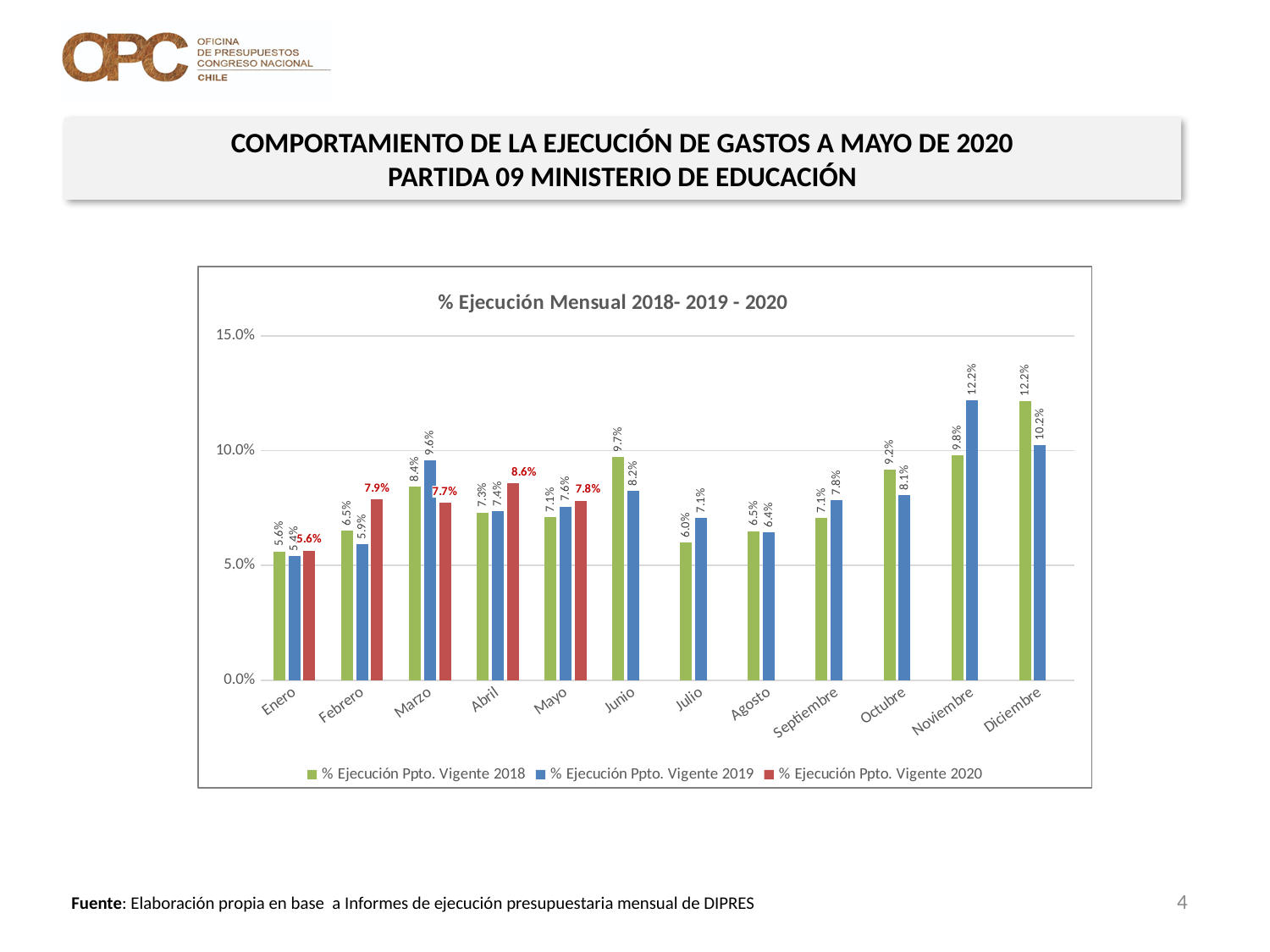
How many months are shown on the x axis? 12 Which month has the highest value for % Ejecución Ppto. Vigente 2018? Diciembre Which month has the lowest value for % Ejecución Ppto. Vigente 2019? Enero What is the value for % Ejecución Ppto. Vigente 2019 in Noviembre? 12.2% What is the value for % Ejecución Ppto. Vigente 2020 in Abril? 8.6% How many series does the legend list? 3 Is the value for % Ejecución Ppto. Vigente 2019 in Diciembre greater or less than 10.0%? greater What is the difference between the 2020 and 2018 values in Febrero? 1.4% What is the value for % Ejecución Ppto. Vigente 2018 in Junio? 9.7% What kind of chart is shown on the slide? Bar chart What is the title of the chart? % Ejecución Mensual 2018- 2019 - 2020 In Marzo, which is larger: the 2018 value or the 2019 value? 2019